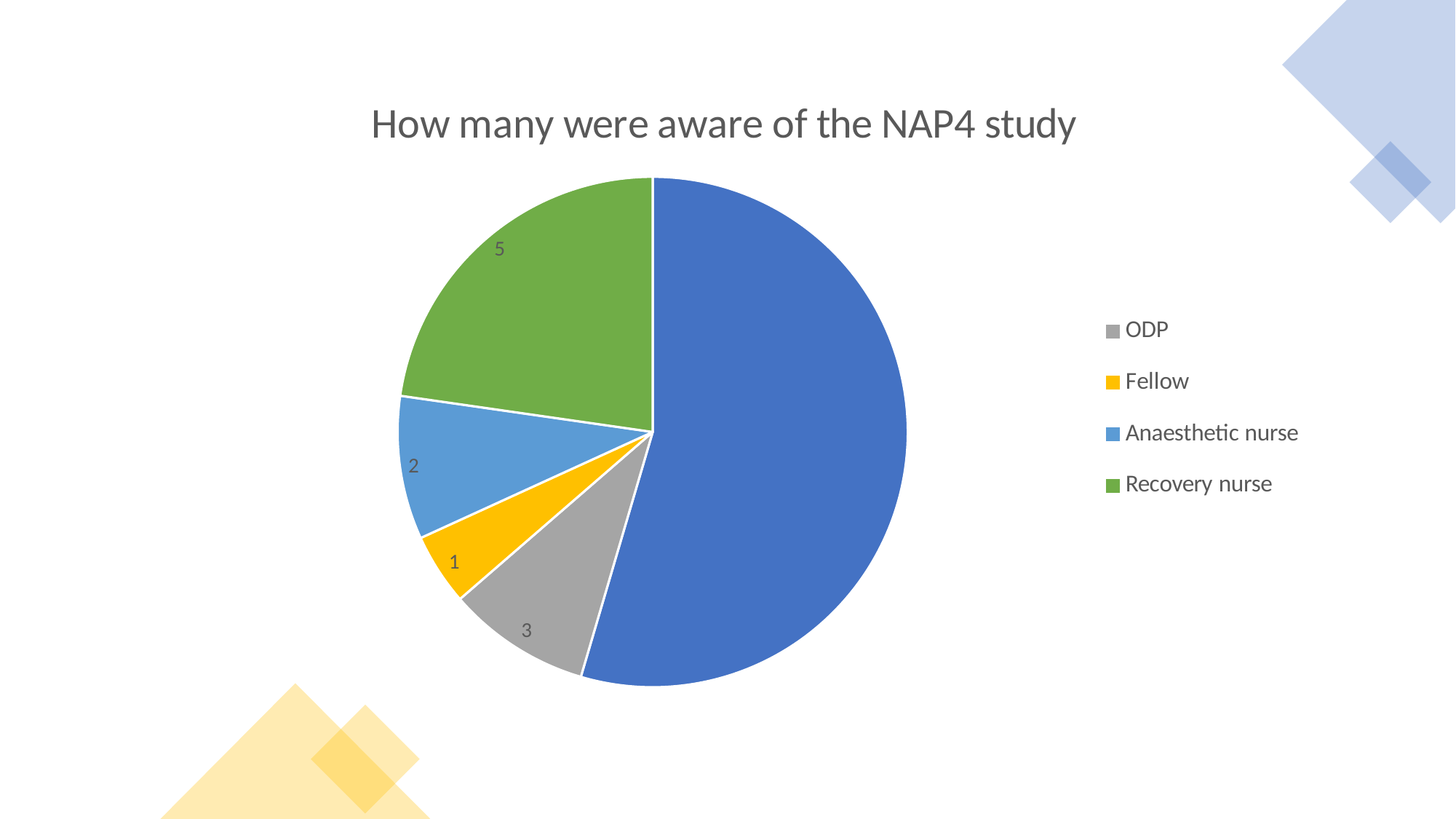
Among the categories listed in the legend, which has the lowest value? Fellow How many entries does the legend list? 4 What is the value for Recovery nurse? 5 What is the value for ODP? 3 Among the categories listed in the legend, which has the highest value? Recovery nurse What is the value for Fellow? 1 What is the value for Anaesthetic nurse? 2 What is the difference between the values for Recovery nurse and ODP? 2 Which is larger, the value for ODP or the value for Anaesthetic nurse? ODP What kind of chart is shown on the slide? Pie chart What is the title of the chart? How many were aware of the NAP4 study What is the difference between the values for Recovery nurse and Anaesthetic nurse? 3